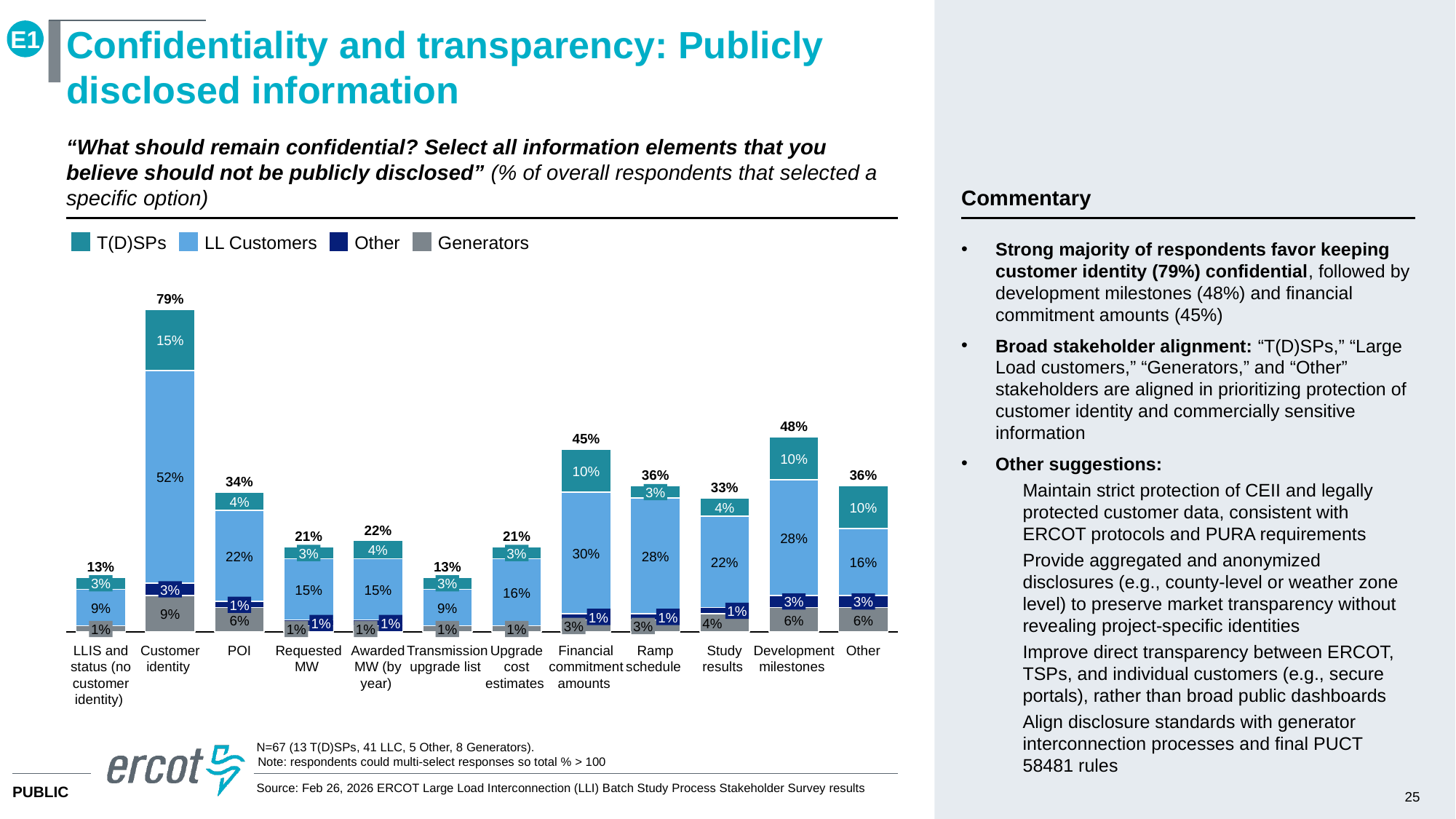
What is the total percentage for Development milestones? 48% Which has a larger total, Financial commitment amounts or Ramp schedule? Financial commitment amounts What is the Other value for Study results? 1% What is the T(D)SPs value for Financial commitment amounts? 10% How many series does the legend list? 4 Which category has the highest total percentage? Customer identity What is the LL Customers value for Customer identity? 52% Which legend entry is shown in gray? Generators How many categories are shown on the x axis of the chart? 12 What is the difference between the total for Customer identity and the total for Development milestones? 31% What type of chart is shown on the slide? Stacked bar chart What is the Generators value for POI? 6%